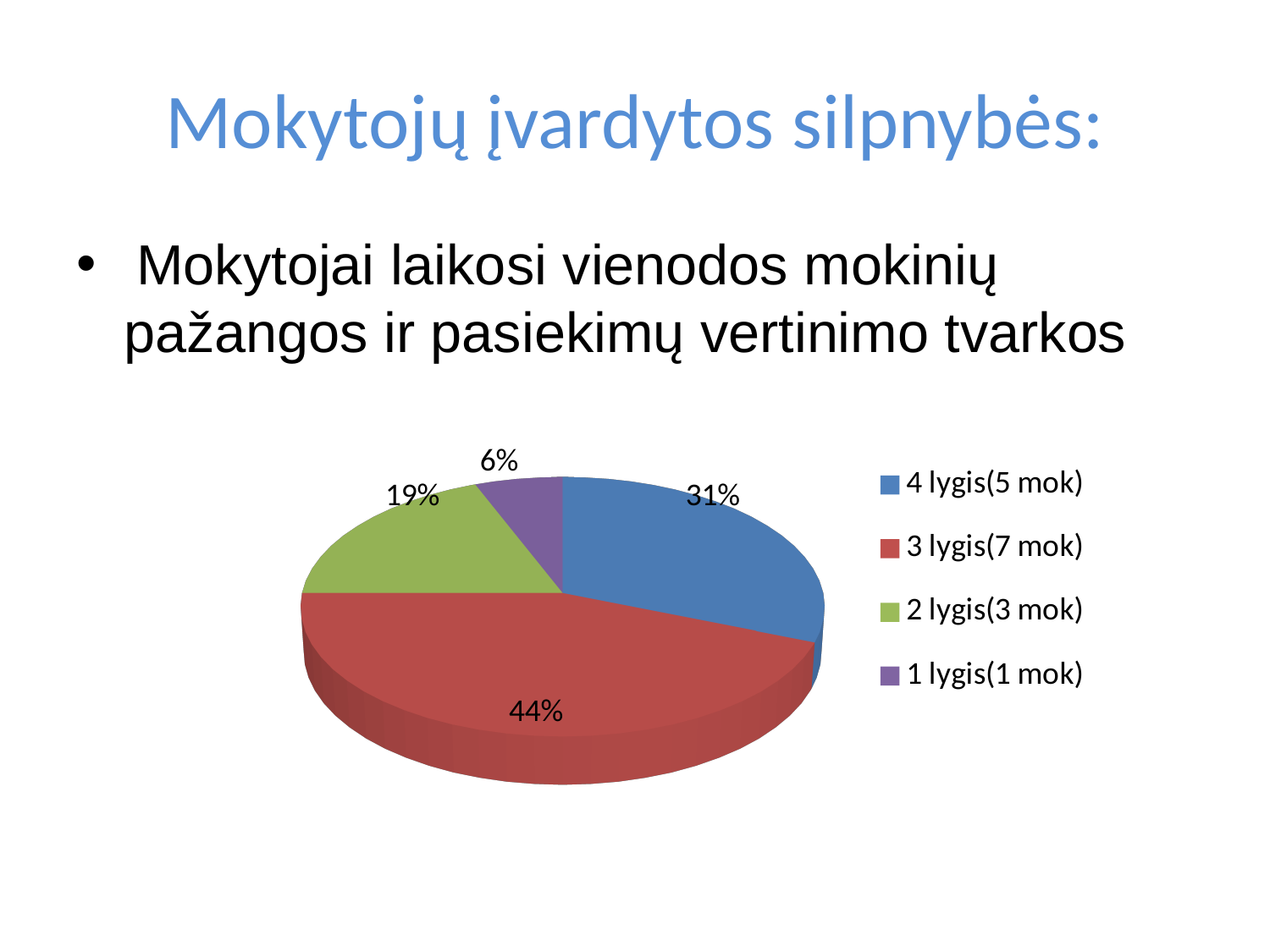
Which slice is larger, "2 lygis(3 mok)" or "1 lygis(1 mok)"? 2 lygis(3 mok) How many slices does the pie chart have? 4 What share of the pie does "2 lygis(3 mok)" have? 19% What is the difference in percentage points between the "3 lygis(7 mok)" slice and the "4 lygis(5 mok)" slice? 13 What share of the pie does "4 lygis(5 mok)" have? 31% What colour is the "3 lygis(7 mok)" slice in the pie chart? red What share of the pie does "3 lygis(7 mok)" have? 44% What kind of chart is shown on the slide? pie chart How many entries does the legend of the pie chart list? 4 Which category has the largest slice of the pie? 3 lygis(7 mok) Which category has the smallest slice of the pie? 1 lygis(1 mok)